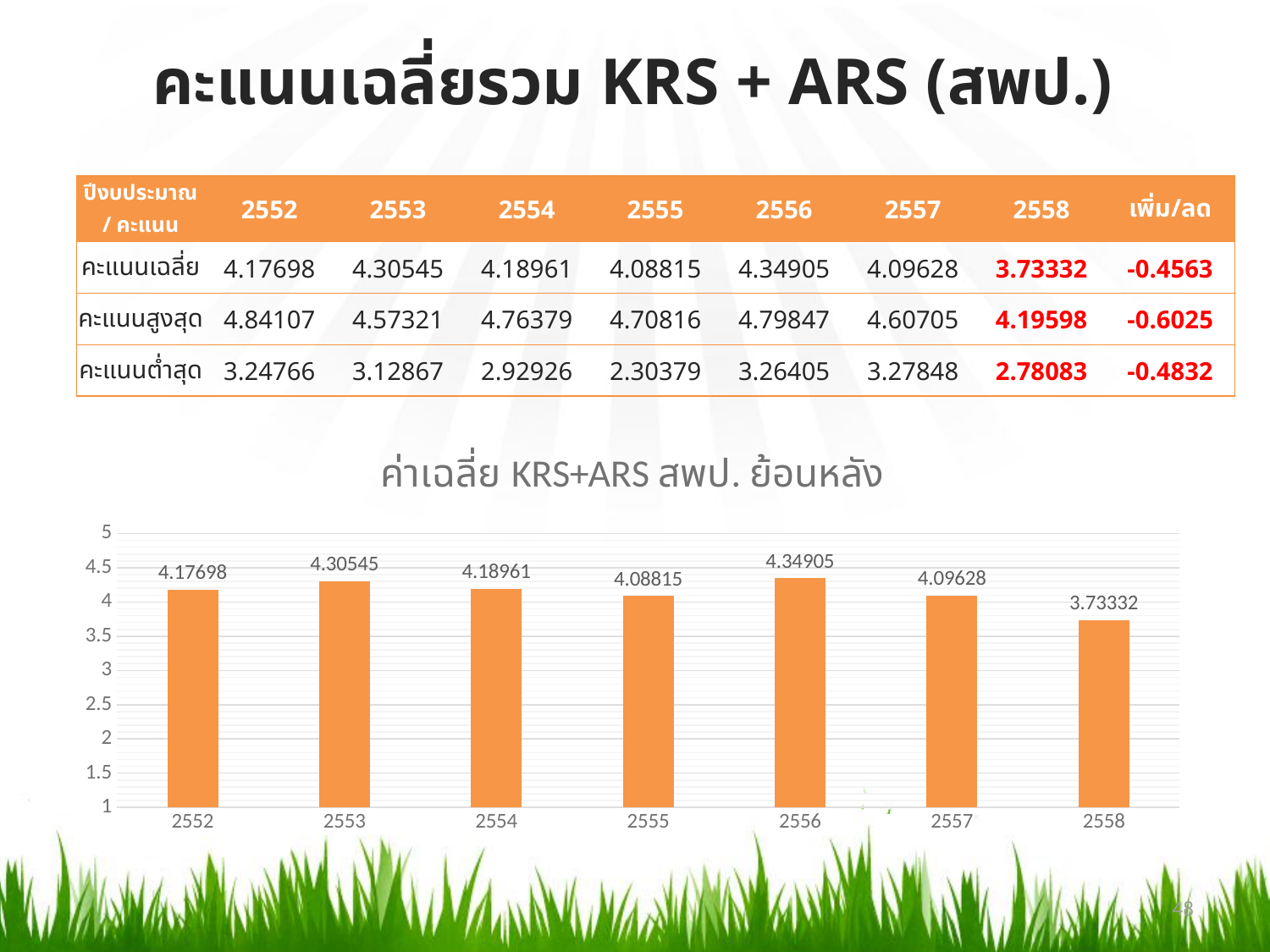
What is the title of the chart? ค่าเฉลี่ย KRS+ARS สพป. ย้อนหลัง Is the value for 2558 greater or less than 4? less What is the value for 2552 in the chart? 4.17698 What is the difference between the values for 2553 and 2552? 0.12847 How many years are shown on the x axis of the chart? 7 What is the value for 2556 in the chart? 4.34905 What type of chart is shown on the slide? bar chart Which is larger, the value for 2553 or the value for 2554? 2553 Which year has the lowest value in the chart? 2558 What is the difference between the values for 2556 and 2558? 0.61573 Which year has the highest value in the chart? 2556 What is the value for 2558 in the chart? 3.73332